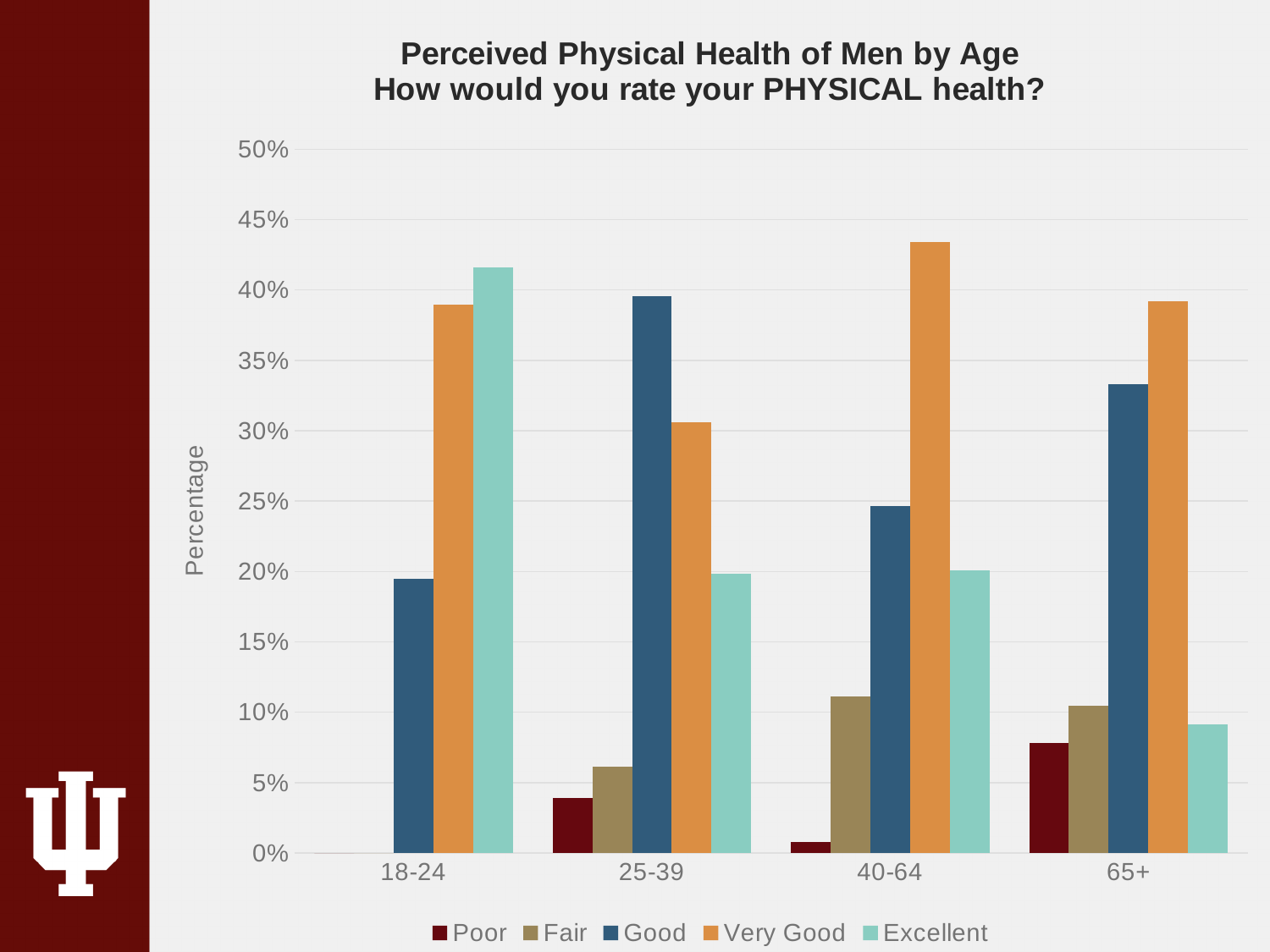
Which age group has the lowest Excellent value? 65+ Which age group has the highest Very Good value? 40-64 Is the Excellent value for the 18-24 age group greater or less than 40%? greater What is the label on the y axis? Percentage Is the Good value for the 18-24 age group greater or less than 25%? less Which age group has the highest Poor value? 65+ For the 25-39 age group, which is larger: Good or Very Good? Good For the 65+ age group, which is larger: Good or Very Good? Very Good How many age groups are shown on the x axis? 4 How many series does the legend list? 5 Is the Very Good value for the 40-64 age group greater or less than 40%? greater What kind of chart is shown on the slide? bar chart